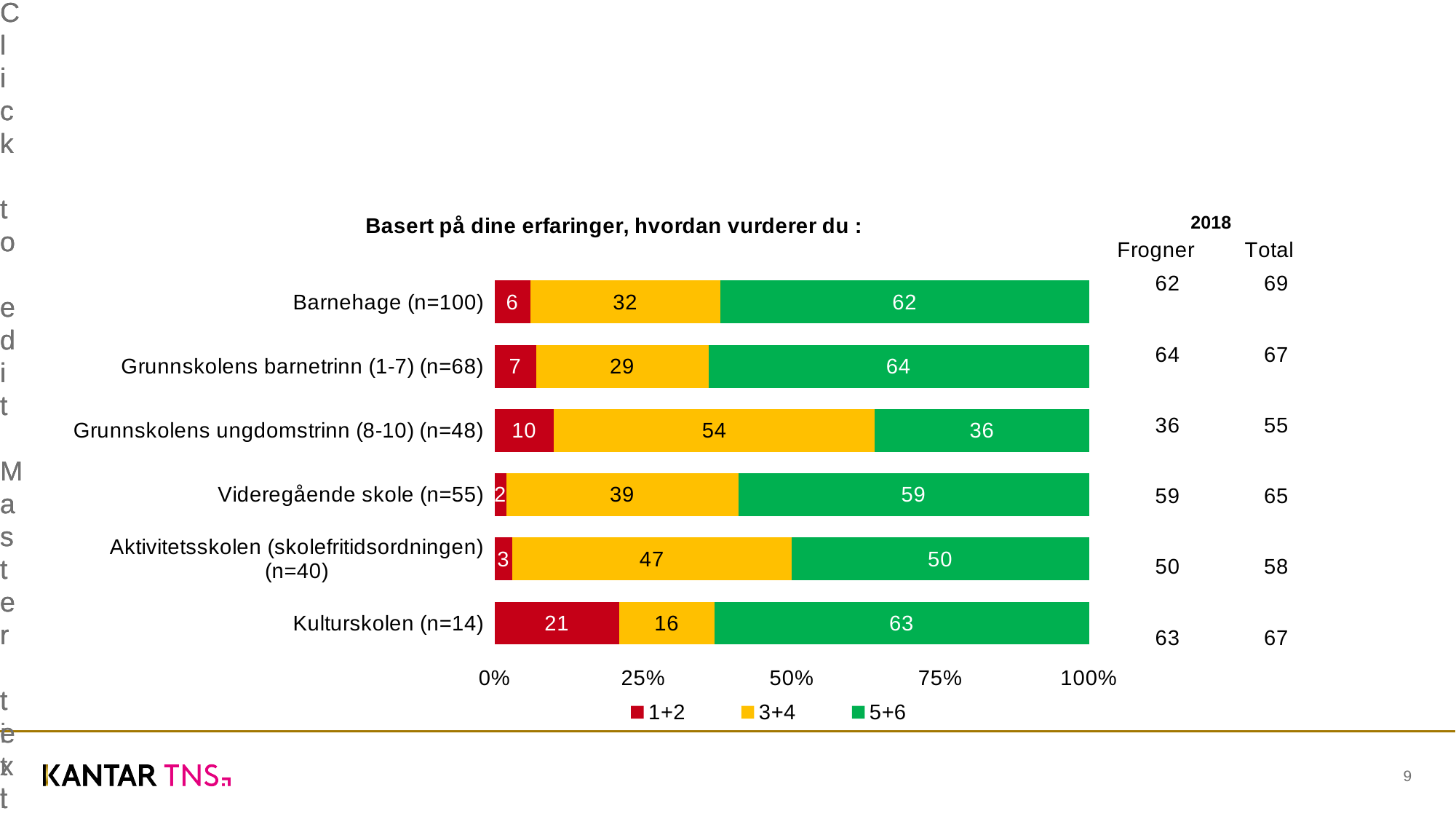
Which category has the highest 1+2 value? Kulturskolen (n=14) Which category has the lowest 5+6 value? Grunnskolens ungdomstrinn (8-10) (n=48) Which is larger: the 3+4 value for Videregående skole (n=55) or the 3+4 value for Barnehage (n=100)? Videregående skole (n=55) What is the 1+2 value for Kulturskolen (n=14)? 21 How many categories are shown in the chart? 6 How many series does the legend list? 3 What kind of chart is shown on the slide? Stacked bar chart What is the 3+4 value for Grunnskolens ungdomstrinn (8-10) (n=48)? 54 What is the difference between the 5+6 values for Grunnskolens barnetrinn (1-7) (n=68) and Aktivitetsskolen (skolefritidsordningen) (n=40)? 14 What is the 5+6 value for Barnehage (n=100)? 62 What is the total of the stacked bar for Kulturskolen (n=14)? 100 What is the title of the chart? Basert på dine erfaringer, hvordan vurderer du :